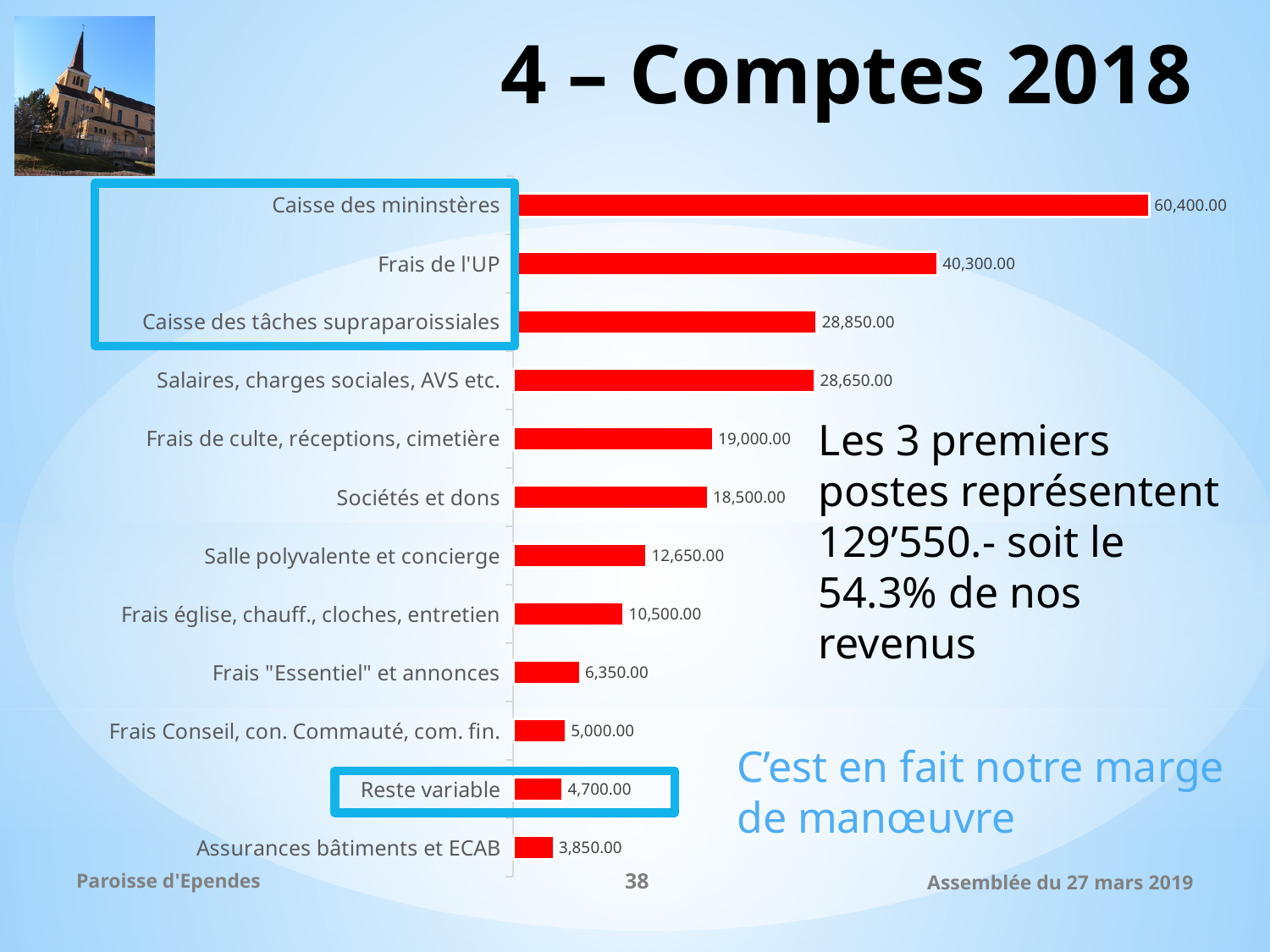
What is the difference between the values for Caisse des mininstères and Frais de l'UP? 20,100.00 What colour are the bars in the chart? Red How many categories are shown in the chart? 12 What is the value for Reste variable? 4,700.00 What is the value for Frais de l'UP? 40,300.00 Which is larger, the value for Sociétés et dons or the value for Salle polyvalente et concierge? Sociétés et dons What is the value for Caisse des mininstères? 60,400.00 What is the difference between the values for Frais église, chauff., cloches, entretien and Frais "Essentiel" et annonces? 4,150.00 Which category has the lowest value? Assurances bâtiments et ECAB What is the value for Salle polyvalente et concierge? 12,650.00 Which category has the highest value? Caisse des mininstères What kind of chart is shown on the slide? Bar chart